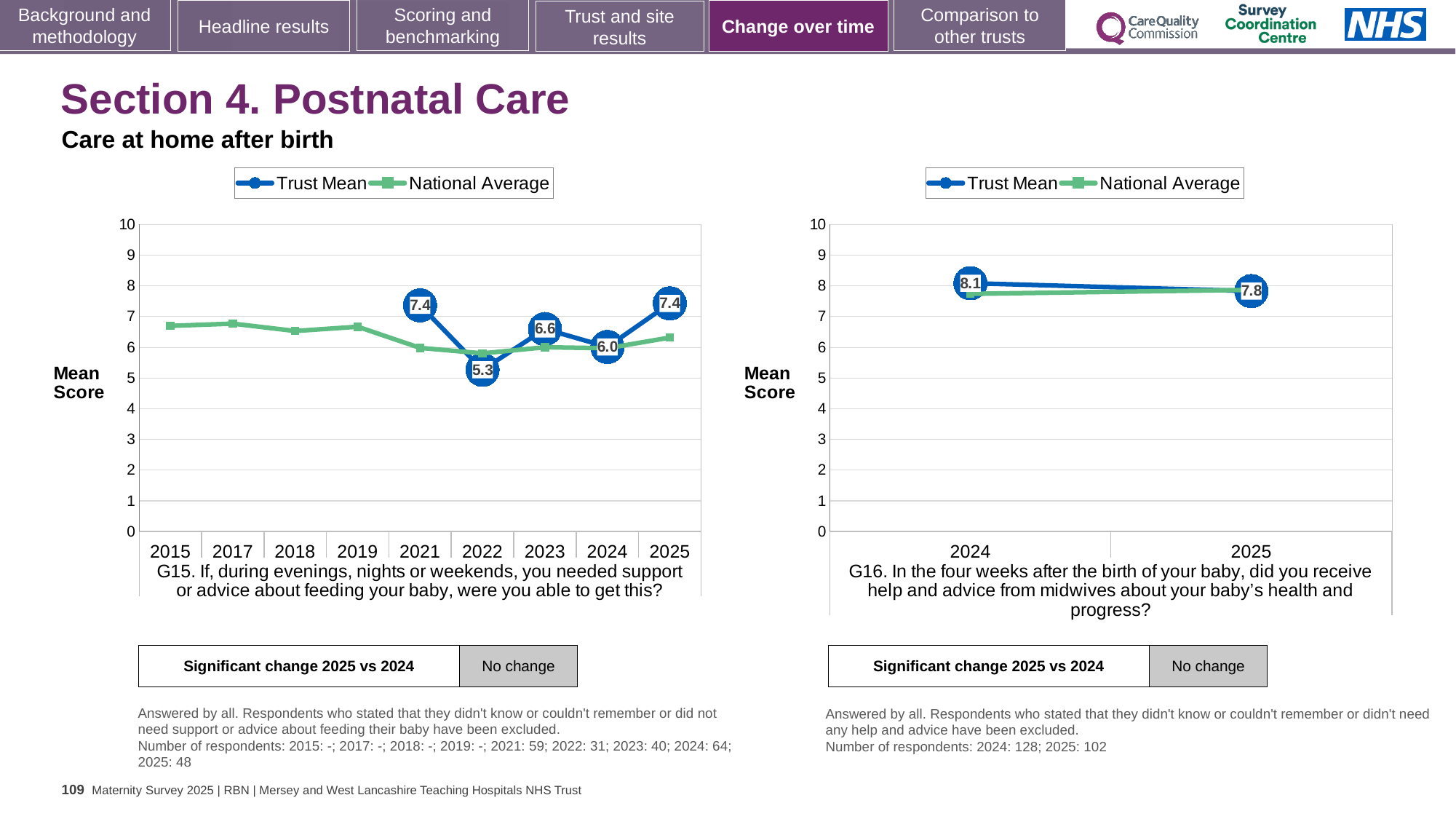
In the left chart (G15), is the National Average value for 2015 greater or less than 6? greater In the right chart (G16), what is the Trust Mean score for 2024? 8.1 In the right chart (G16), what is the difference between the Trust Mean scores for 2024 and 2025? 0.3 In the left chart (G15), how many years are shown on the x axis? 9 In the left chart (G15), which year has the lowest Trust Mean score? 2022 In the left chart (G15), what is the difference between the Trust Mean scores for 2025 and 2024? 1.4 In the left chart (G15), what is the Trust Mean score for 2025? 7.4 What kind of chart is the left chart (G15)? Line chart In the left chart (G15), is the Trust Mean score for 2023 larger than the Trust Mean score for 2024? Yes In the left chart (G15), what is the Trust Mean score for 2022? 5.3 In the right chart (G16), does the Trust Mean rise or fall from 2024 to 2025? Fall How many series does the legend of the right chart (G16) list? 2